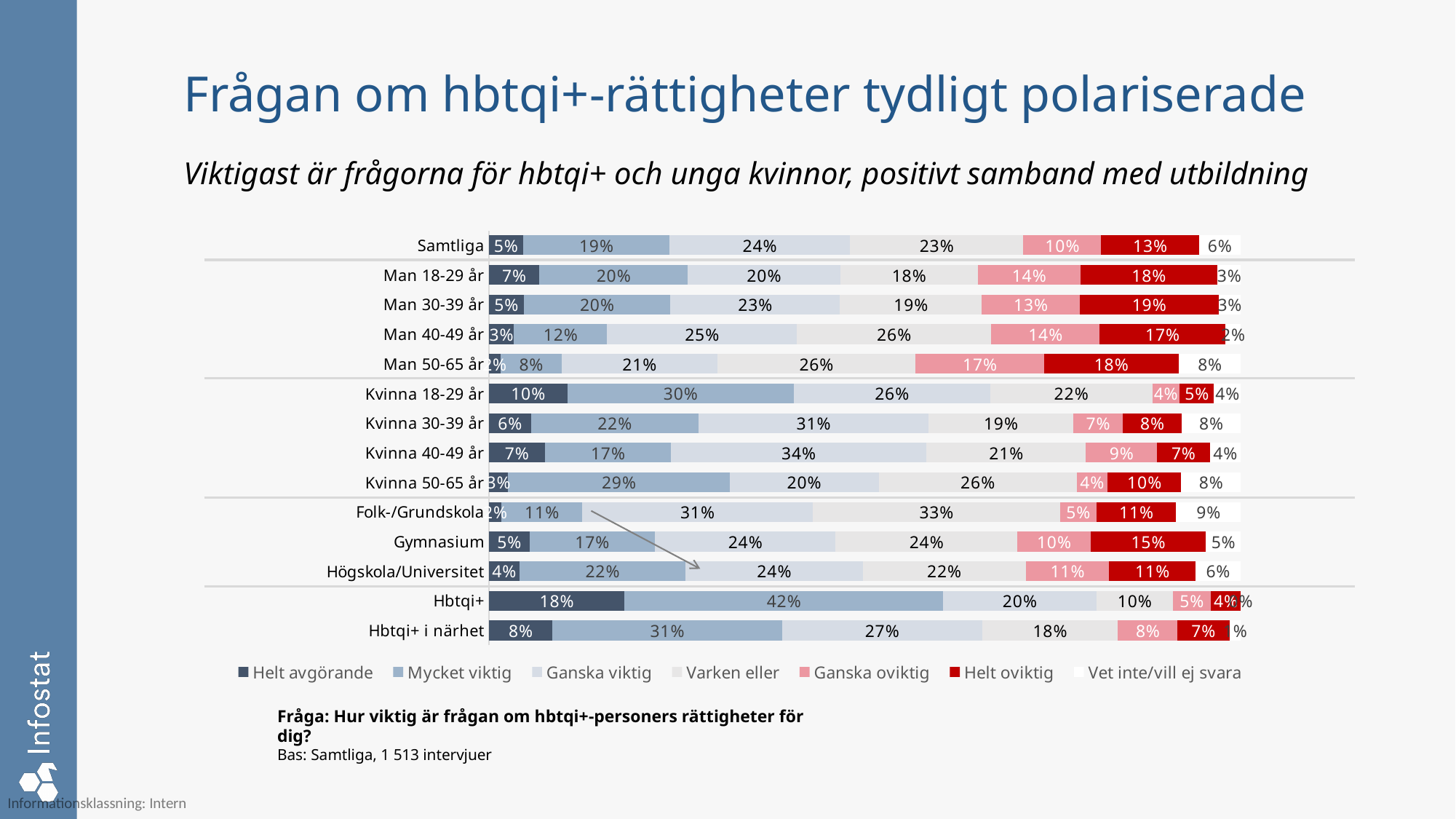
What is the value for "Ganska oviktig" in the Man 50-65 år bar? 17% What is the value for "Mycket viktig" in the Samtliga bar? 19% What kind of chart is shown on the slide? Stacked bar chart What is the difference in percentage points between the "Mycket viktig" values for Kvinna 18-29 år and Man 18-29 år? 10 percentage points What is the value for "Varken eller" in the Folk-/Grundskola bar? 33% Which category has the highest value for "Helt avgörande"? Hbtqi+ How many series does the legend list? 7 What is the value for "Helt avgörande" in the Hbtqi+ bar? 18% Which has the larger "Ganska viktig" value, Kvinna 40-49 år or Man 40-49 år? Kvinna 40-49 år Which category has the highest value for "Helt oviktig"? Man 30-39 år Which category has the lowest value for "Helt oviktig"? Hbtqi+ How many categories (bars) are shown in the chart? 14